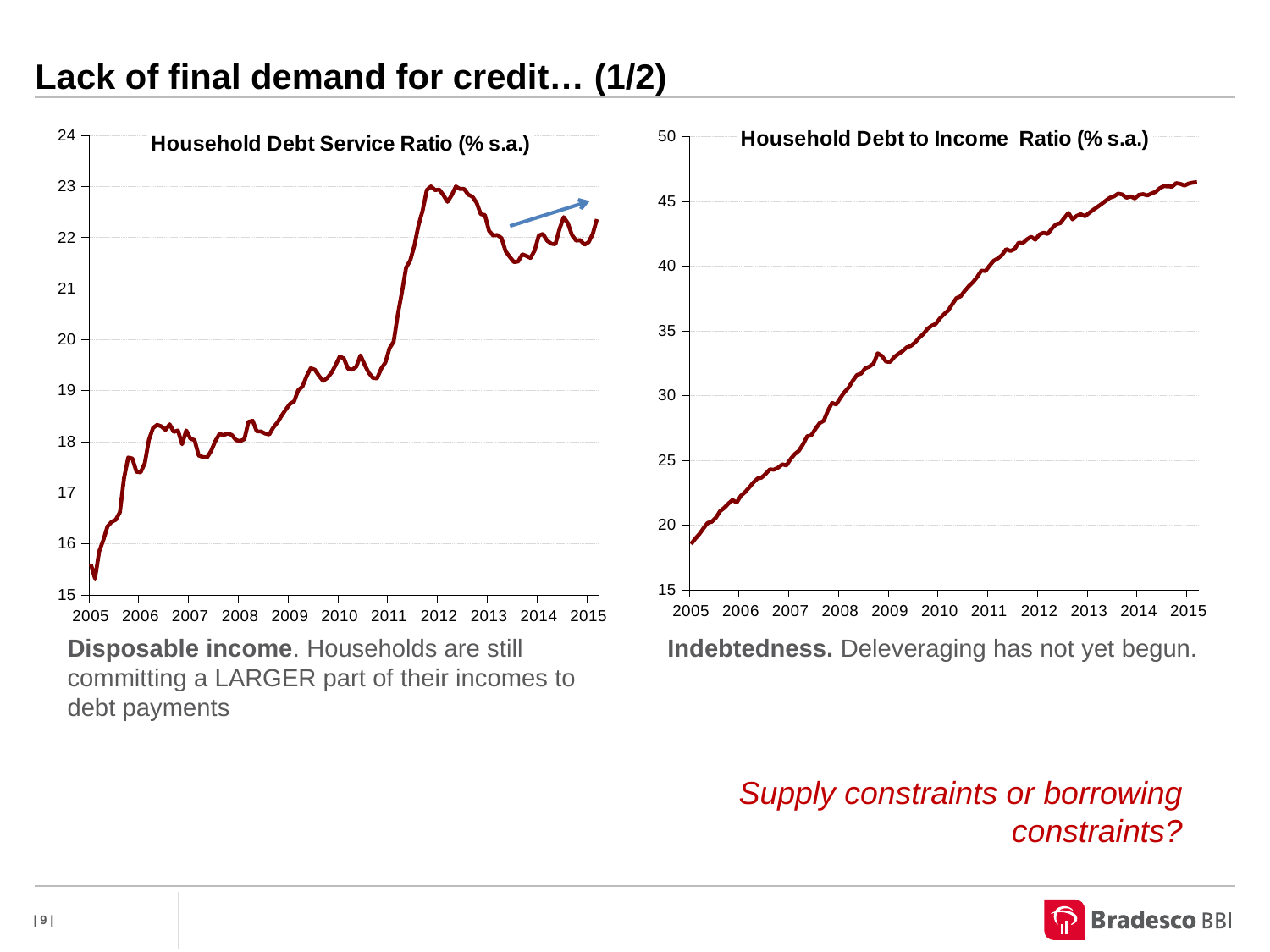
What is the title of the chart on the right side of the slide? Household Debt to Income Ratio (% s.a.) In the Household Debt to Income Ratio chart, is the value at the start of 2012 greater or less than 40? greater In the Household Debt to Income Ratio chart, is the value at 2015 greater or less than 45? greater In the Household Debt Service Ratio chart, is the value at the start of 2005 greater or less than 16? less What kind of chart is the Household Debt Service Ratio (% s.a.) chart on the left? line chart How many year labels are shown on the x axis of the Household Debt Service Ratio chart? 11 What is the highest value shown on the y axis of the Household Debt Service Ratio chart? 24 In the Household Debt to Income Ratio chart, do values generally rise or fall from 2005 to 2015? rise What kind of chart is the Household Debt to Income Ratio (% s.a.) chart on the right? line chart